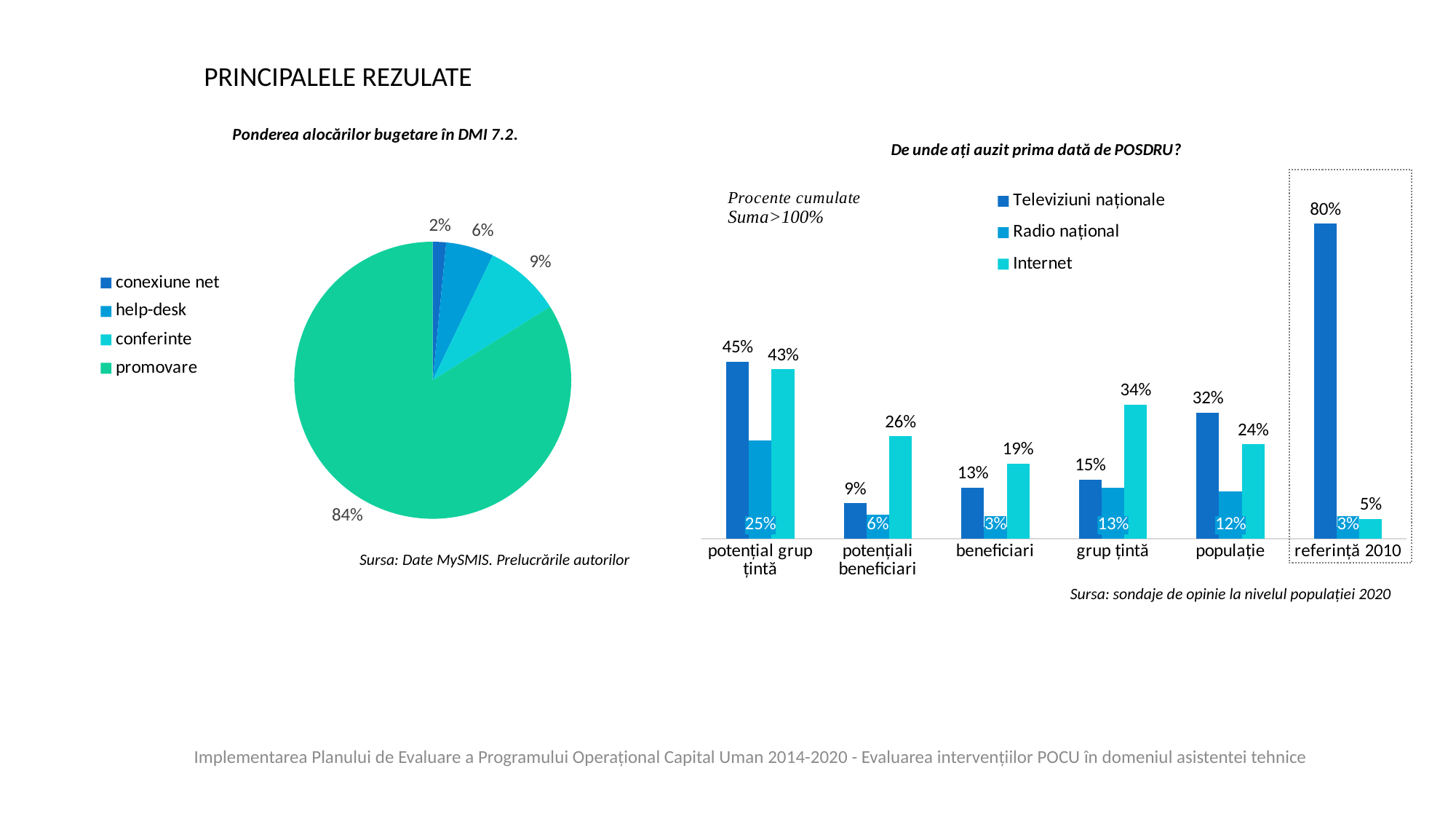
In the bar chart 'De unde ați auzit prima dată de POSDRU?', which is larger for potențiali beneficiari: Televiziuni naționale or Internet? Internet How many series does the legend of the bar chart 'De unde ați auzit prima dată de POSDRU?' list? 3 In the bar chart 'De unde ați auzit prima dată de POSDRU?', what is the value for Radio național in the potențial grup țintă category? 25% What type of chart is 'De unde ați auzit prima dată de POSDRU?'? bar chart How many categories are shown on the x axis of the bar chart 'De unde ați auzit prima dată de POSDRU?'? 6 In the bar chart 'De unde ați auzit prima dată de POSDRU?', what is the value for Televiziuni naționale in the referință 2010 category? 80% How many categories does the pie chart 'Ponderea alocărilor bugetare în DMI 7.2.' show? 4 In the pie chart 'Ponderea alocărilor bugetare în DMI 7.2.', which category has the smallest slice? conexiune net In the bar chart 'De unde ați auzit prima dată de POSDRU?', what is the difference between Televiziuni naționale and Internet in the populație category? 8% In the pie chart 'Ponderea alocărilor bugetare în DMI 7.2.', what share does promovare have? 84% In the bar chart 'De unde ați auzit prima dată de POSDRU?', what is the value for Internet in the grup țintă category? 34% In the pie chart 'Ponderea alocărilor bugetare în DMI 7.2.', what is the value for conferinte? 9%